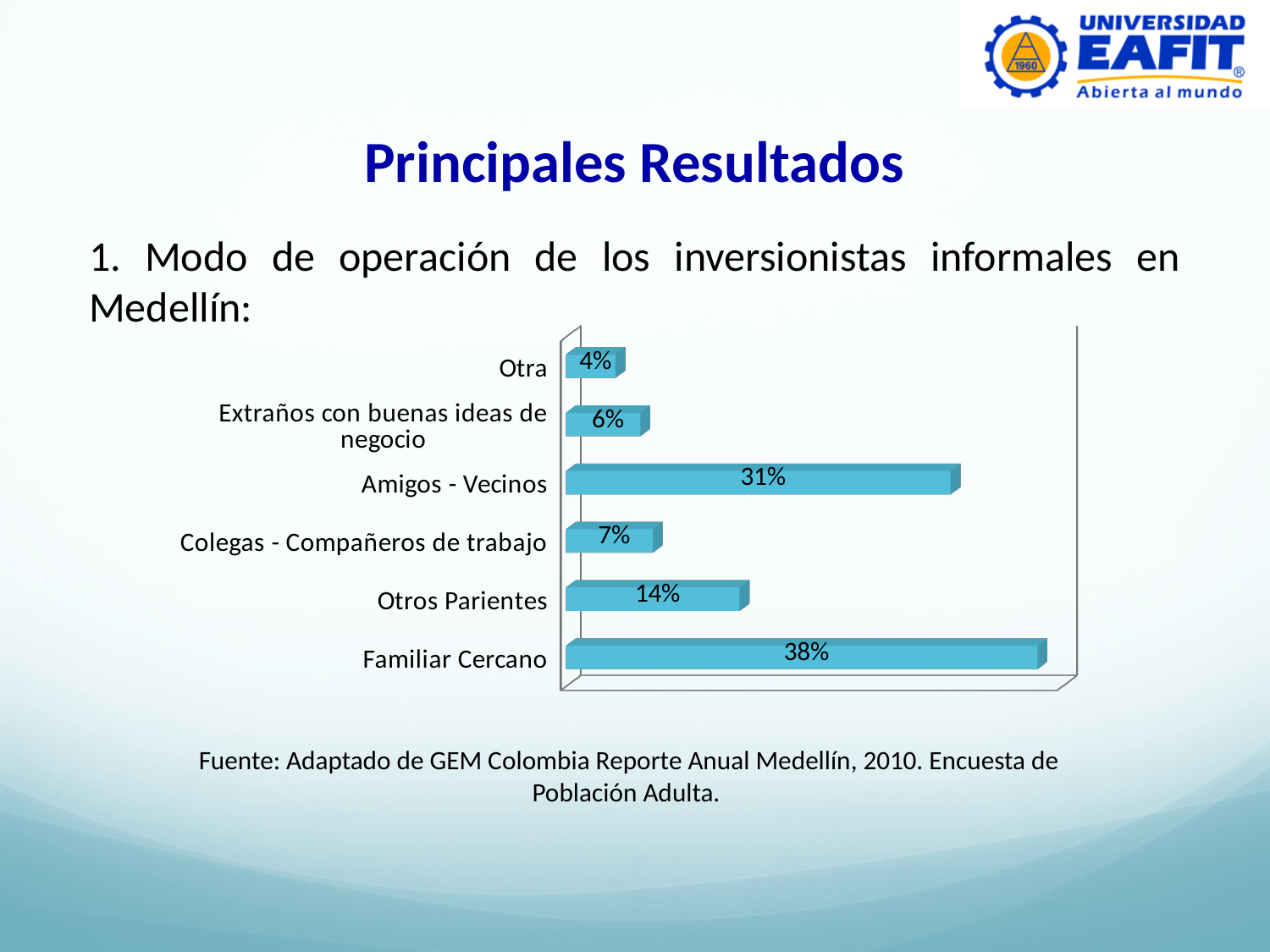
What is the value for Otros Parientes? 14% How many categories are shown in the chart? 6 What is the difference between the values for Familiar Cercano and Amigos - Vecinos? 7% What kind of chart is shown on the slide? Bar chart What is the difference between the values for Otros Parientes and Colegas - Compañeros de trabajo? 7% Which category has the lowest value? Otra Which category has the highest value? Familiar Cercano What is the value for Extraños con buenas ideas de negocio? 6% What is the value for Amigos - Vecinos? 31% Which is larger, the value for Otros Parientes or the value for Extraños con buenas ideas de negocio? Otros Parientes What is the value for Familiar Cercano? 38% What is the value for Colegas - Compañeros de trabajo? 7%